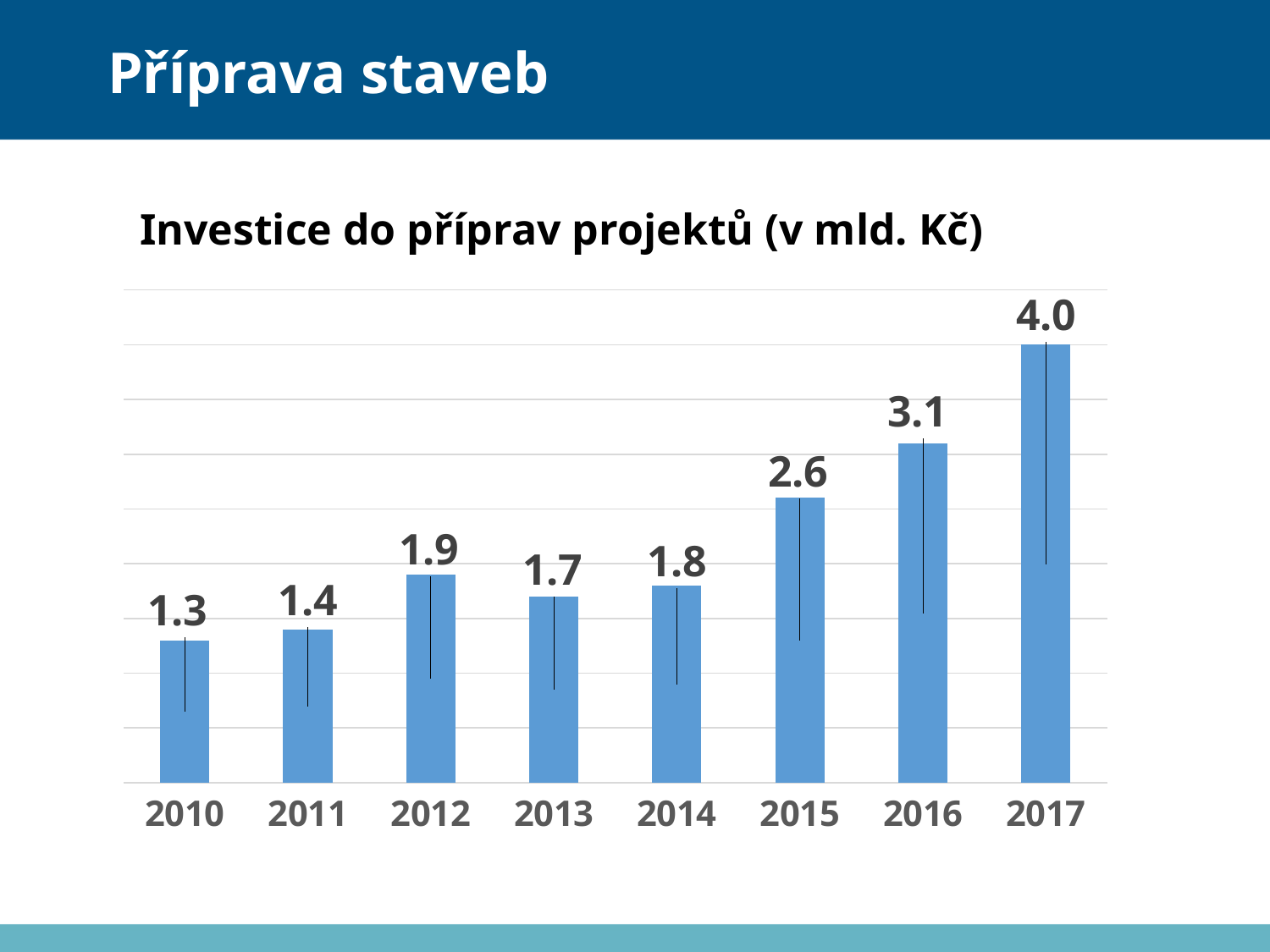
How many years are shown on the x axis? 8 Which year has the lowest value? 2010 Which year has the highest value? 2017 What kind of chart is this? bar chart What is the value for 2012? 1.9 What is the difference between the values for 2017 and 2016? 0.9 Which is larger, the value for 2014 or the value for 2012? 2012 What is the value for 2015? 2.6 Do the values generally rise or fall from 2013 to 2017? rise What is the value for 2010? 1.3 What is the title of the chart? Investice do příprav projektů (v mld. Kč) What is the difference between the values for 2012 and 2013? 0.2